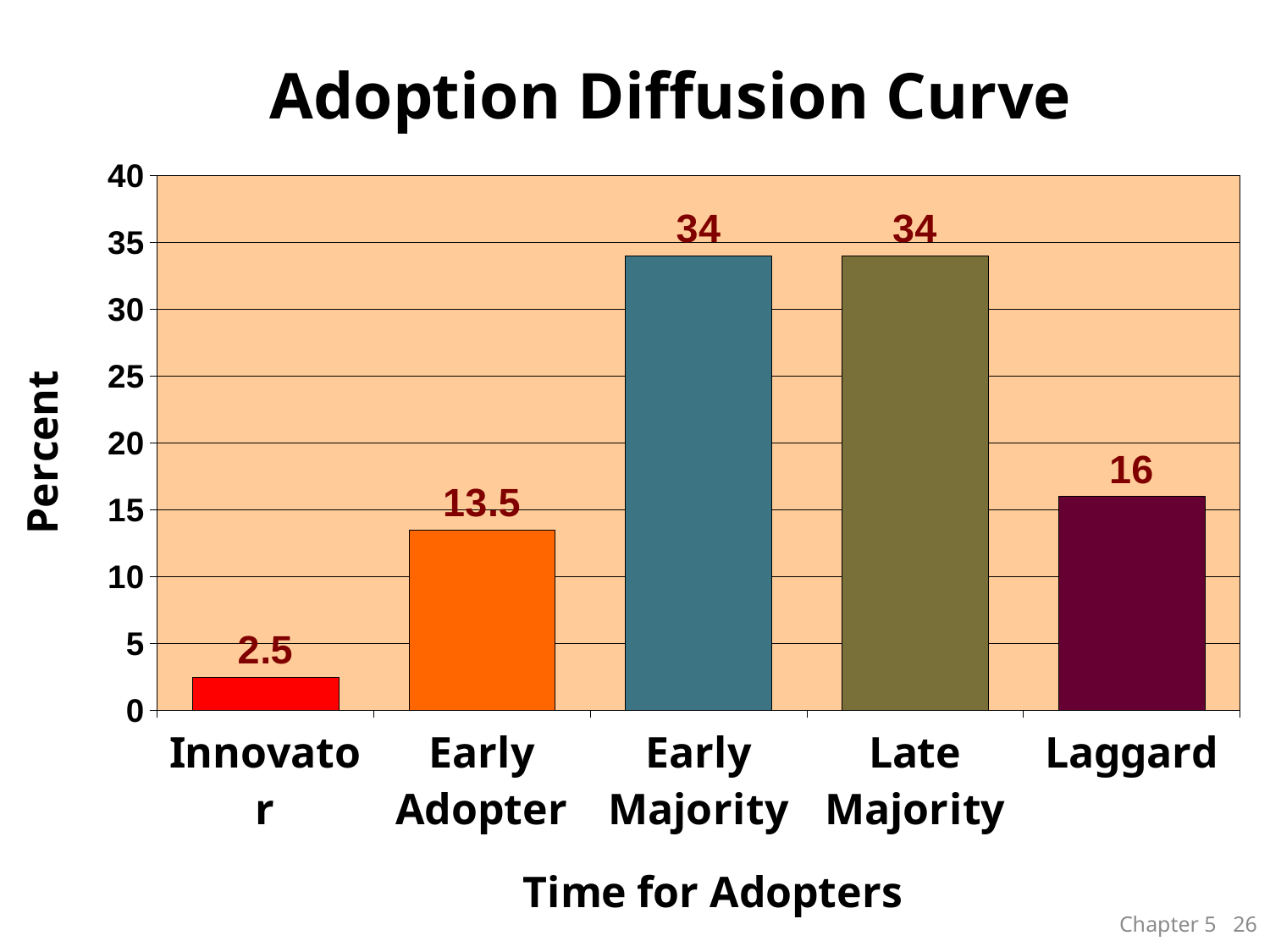
What is the difference between the values for Early Majority and Laggard? 18 What is the value for Innovator? 2.5 Which is larger, the value for Laggard or the value for Early Adopter? Laggard What is the value for Laggard? 16 Which category has the lowest value? Innovator What is the title of the chart? Adoption Diffusion Curve What is the value for Late Majority? 34 Is the value for Early Majority greater or less than 30? greater What kind of chart is shown on the slide? bar chart How many categories are shown on the x axis? 5 What is the difference between the values for Laggard and Early Adopter? 2.5 What is the value for Early Adopter? 13.5